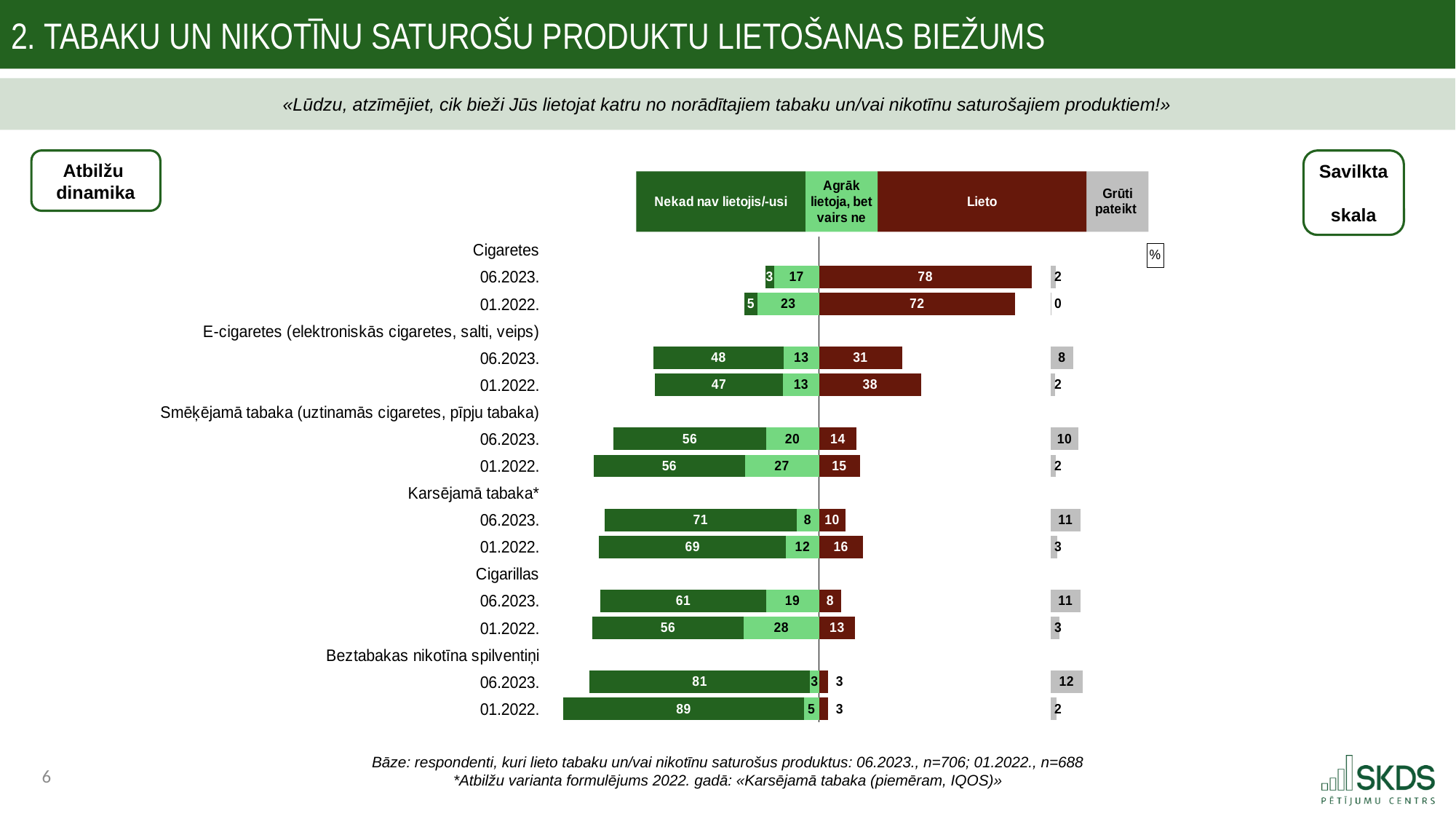
How many series does the legend list? 4 Which colour represents the "Lieto" series in the chart? Dark red Which product has the lowest "Lieto" value in 06.2023? Beztabakas nikotīna spilventiņi By how many points did the "Lieto" value for E-cigaretes change from 01.2022 to 06.2023? 7 What is the "Grūti pateikt" value for Karsējamā tabaka in 06.2023? 11 Which product has the highest "Lieto" value in 06.2023? Cigaretes How many products are compared in the chart? 6 What is the "Agrāk lietoja, bet vairs ne" value for Cigarillas in 01.2022? 28 What is the "Nekad nav lietojis/-usi" value for Beztabakas nikotīna spilventiņi in 01.2022? 89 What kind of chart is shown on the slide? Stacked bar chart What percentage of respondents said they use ("Lieto") cigarettes in 06.2023? 78 Is the "Lieto" value for Smēķējamā tabaka larger in 06.2023 or in 01.2022? 01.2022